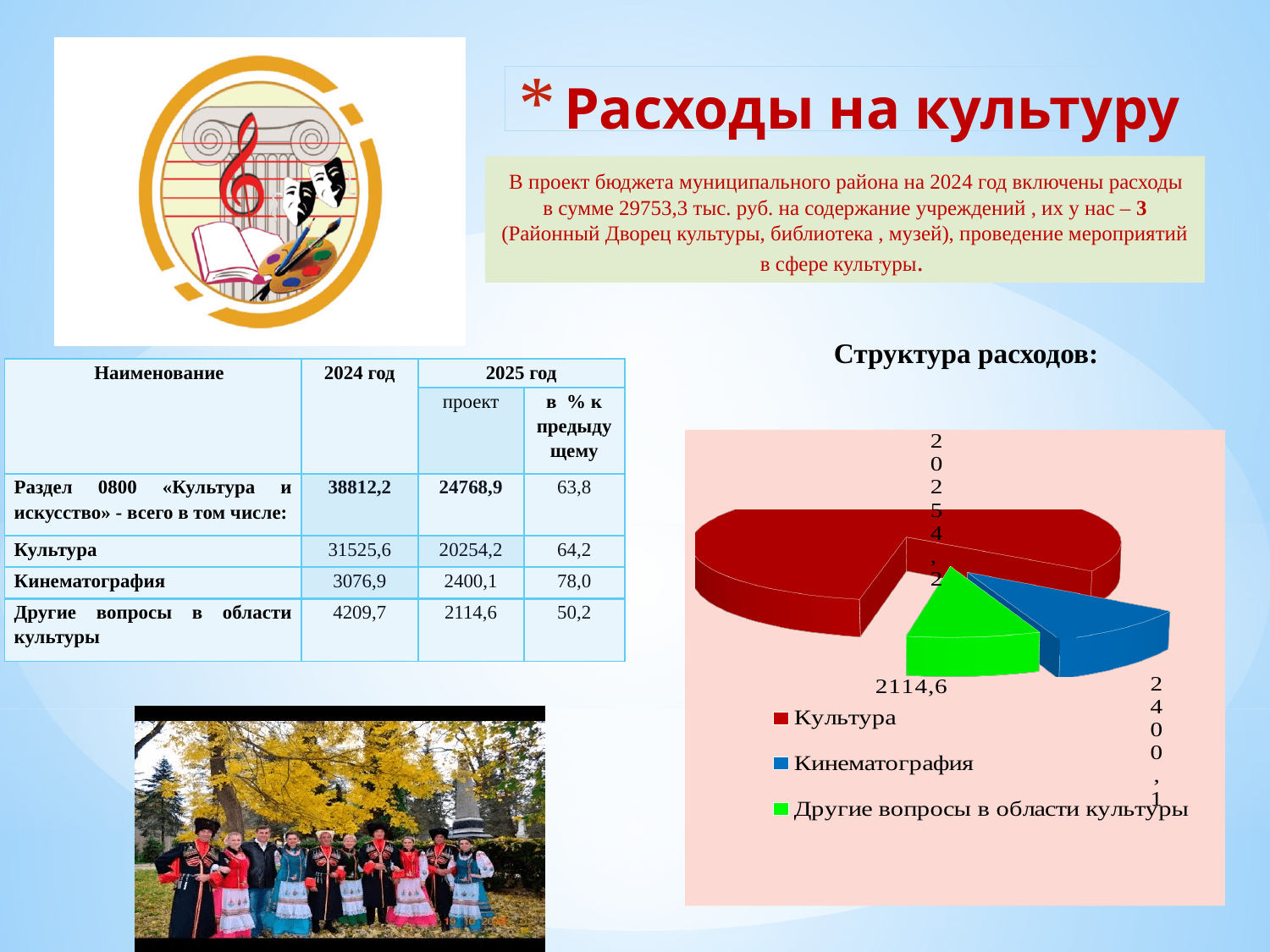
In the pie chart, what is the value for Другие вопросы в области культуры? 2114,6 In the pie chart, which is larger: Кинематография or Другие вопросы в области культуры? Кинематография How many slices does the pie chart «Структура расходов:» have? 3 What is the total of all three slices in the pie chart? 24768,9 Which slice of the pie chart is the smallest? Другие вопросы в области культуры Which slice of the pie chart is the largest? Культура Which colour represents Кинематография in the pie chart? blue In the pie chart, what is the difference between the values for Кинематография and Другие вопросы в области культуры? 285,5 How many entries does the legend of the pie chart list? 3 What kind of chart is shown under the heading «Структура расходов:»? pie chart In the pie chart, what is the value for Кинематография? 2400,1 In the pie chart, what is the value for Культура? 20254,2